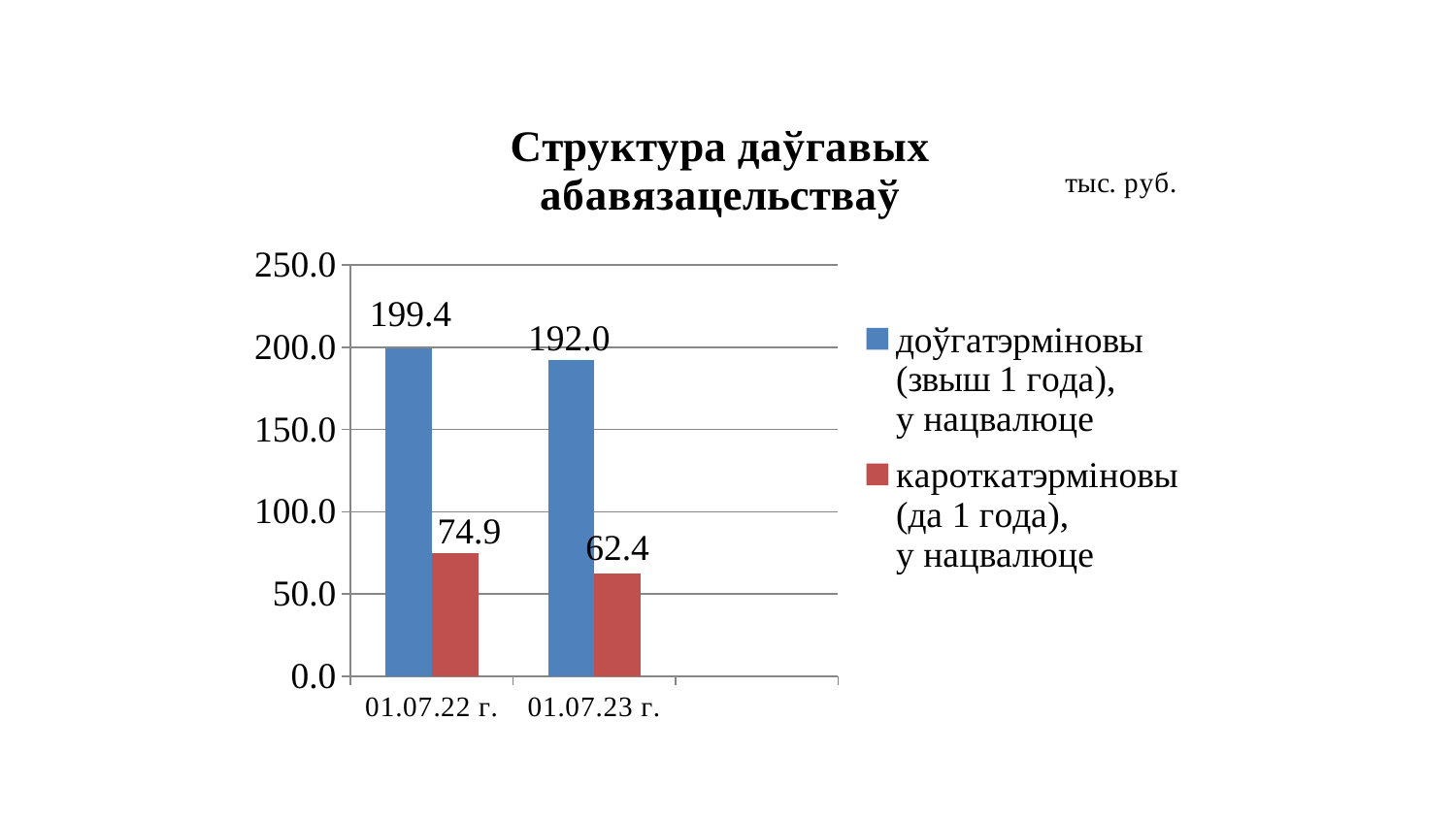
Which is larger for 01.07.23 г.: the long-term or the short-term value? long-term (доўгатэрміновы) What is the value of the short-term (кароткатэрміновы) series for 01.07.22 г.? 74.9 What is the value of the long-term (доўгатэрміновы) series for 01.07.22 г.? 199.4 What is the difference between the long-term values for 01.07.22 г. and 01.07.23 г.? 7.4 What kind of chart is shown on the slide? bar chart What is the value of the long-term (доўгатэрміновы) series for 01.07.23 г.? 192.0 Which date has the higher value for the long-term (доўгатэрміновы) series? 01.07.22 г. How many series does the legend list? 2 What is the value of the short-term (кароткатэрміновы) series for 01.07.23 г.? 62.4 How many dates are shown on the x axis? 2 Which date has the lower value for the short-term (кароткатэрміновы) series? 01.07.23 г. What is the difference between the short-term values for 01.07.22 г. and 01.07.23 г.? 12.5